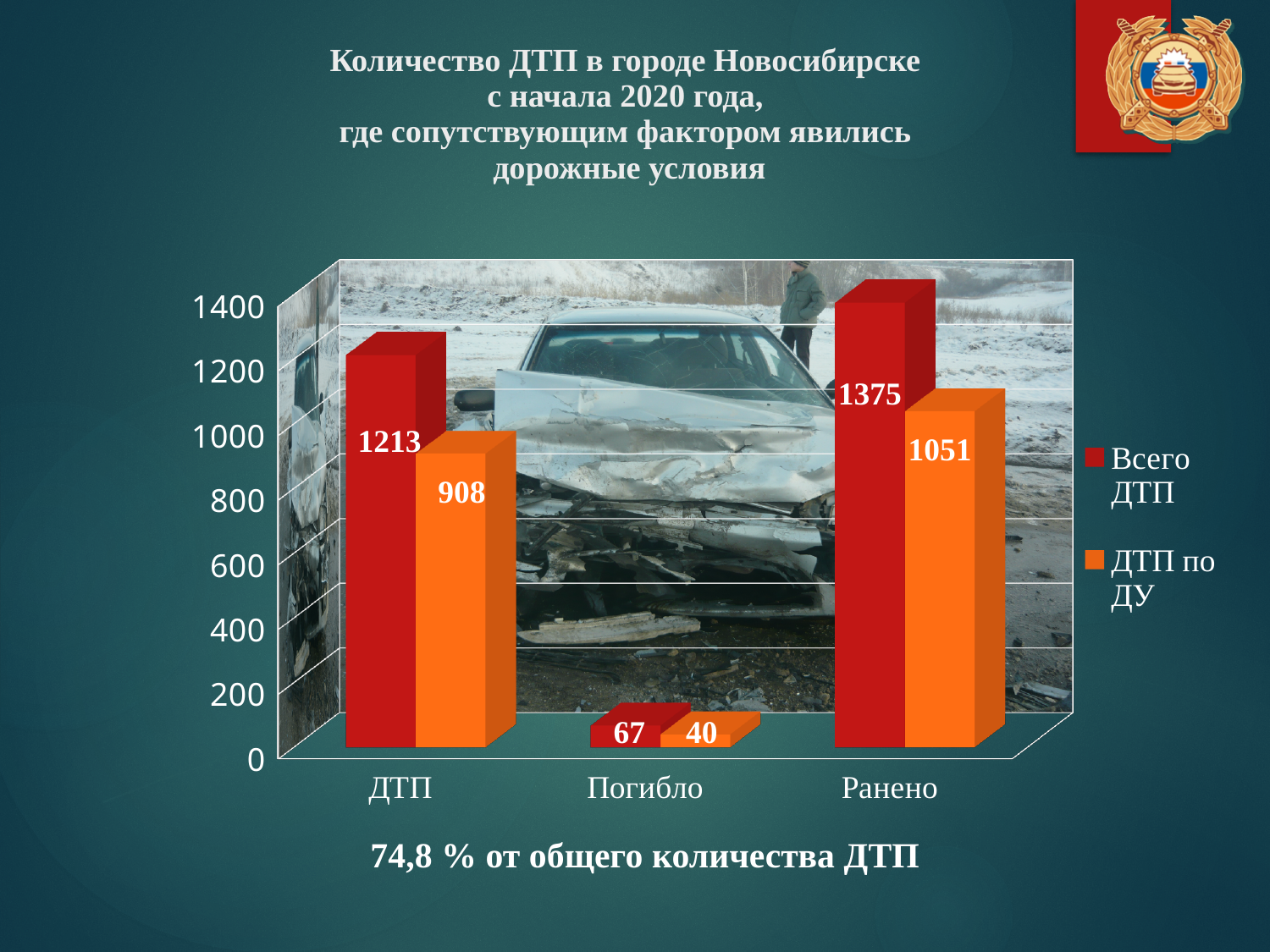
What is the difference between "Всего ДТП" and "ДТП по ДУ" for the category "Погибло"? 27 Which category has the lowest value for the "ДТП по ДУ" series? Погибло Which category has the highest value for the "Всего ДТП" series? Ранено What kind of chart is shown on the slide? Bar chart What is the difference between "Всего ДТП" and "ДТП по ДУ" for the category "Ранено"? 324 What is the value of "Всего ДТП" for the category "Погибло"? 67 What is the value of "ДТП по ДУ" for the category "ДТП"? 908 How many series does the legend list? 2 What is the value of "Всего ДТП" for the category "ДТП"? 1213 What is the value of "ДТП по ДУ" for the category "Ранено"? 1051 Which is larger: "Всего ДТП" for "ДТП" or "Всего ДТП" for "Ранено"? Всего ДТП for Ранено How many categories are shown on the x axis of the chart? 3